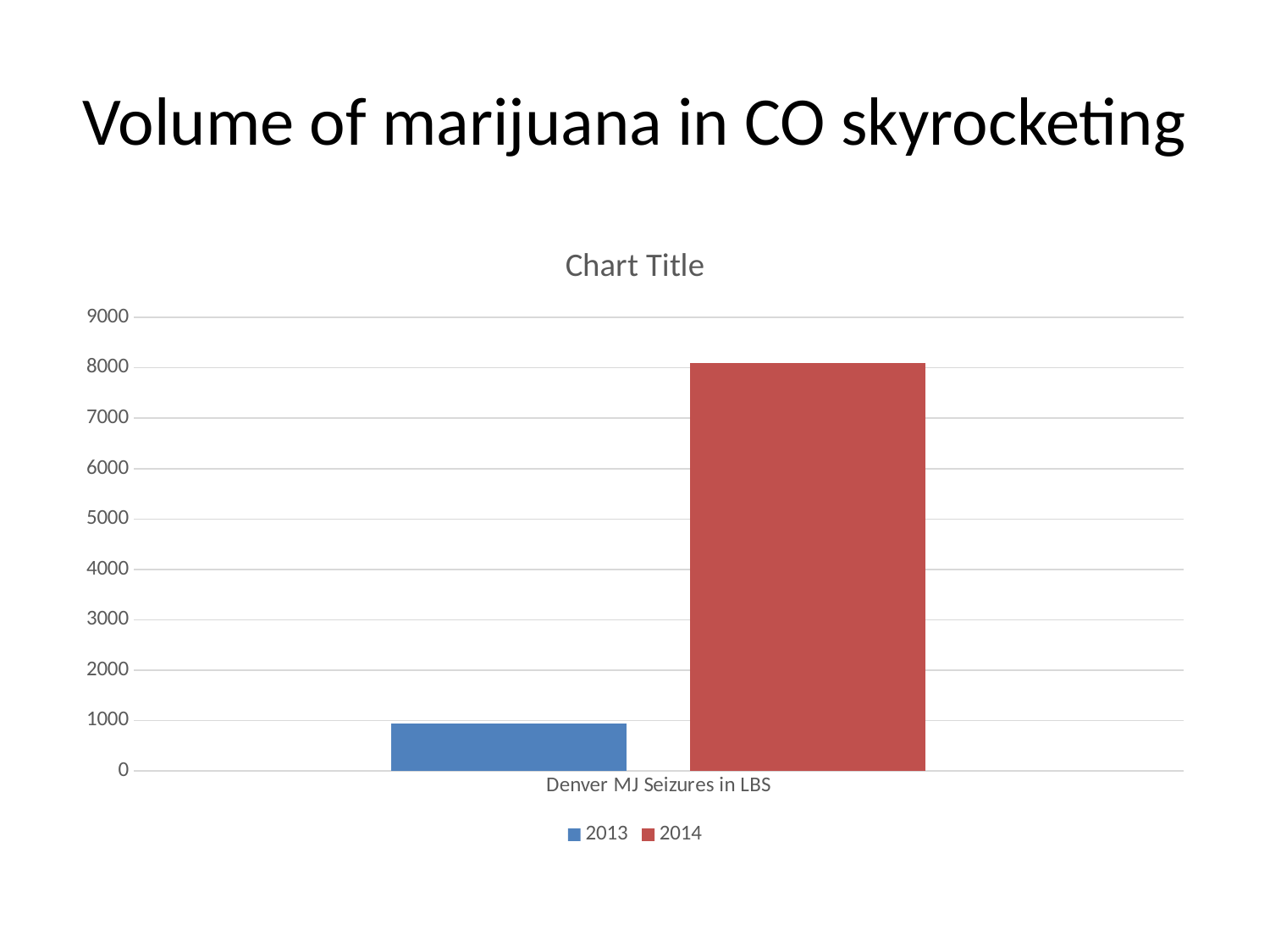
Which series has the higher value for Denver MJ Seizures in LBS, 2013 or 2014? 2014 Is the value for 2014 greater or less than 9000? less What is the category label on the x axis? Denver MJ Seizures in LBS Which series has the lowest value in the chart? 2013 How many series does the legend list? 2 What is the highest value shown on the y axis? 9000 What colour is the bar for 2014? red What kind of chart is shown on the slide? bar chart How many categories are shown on the x axis? 1